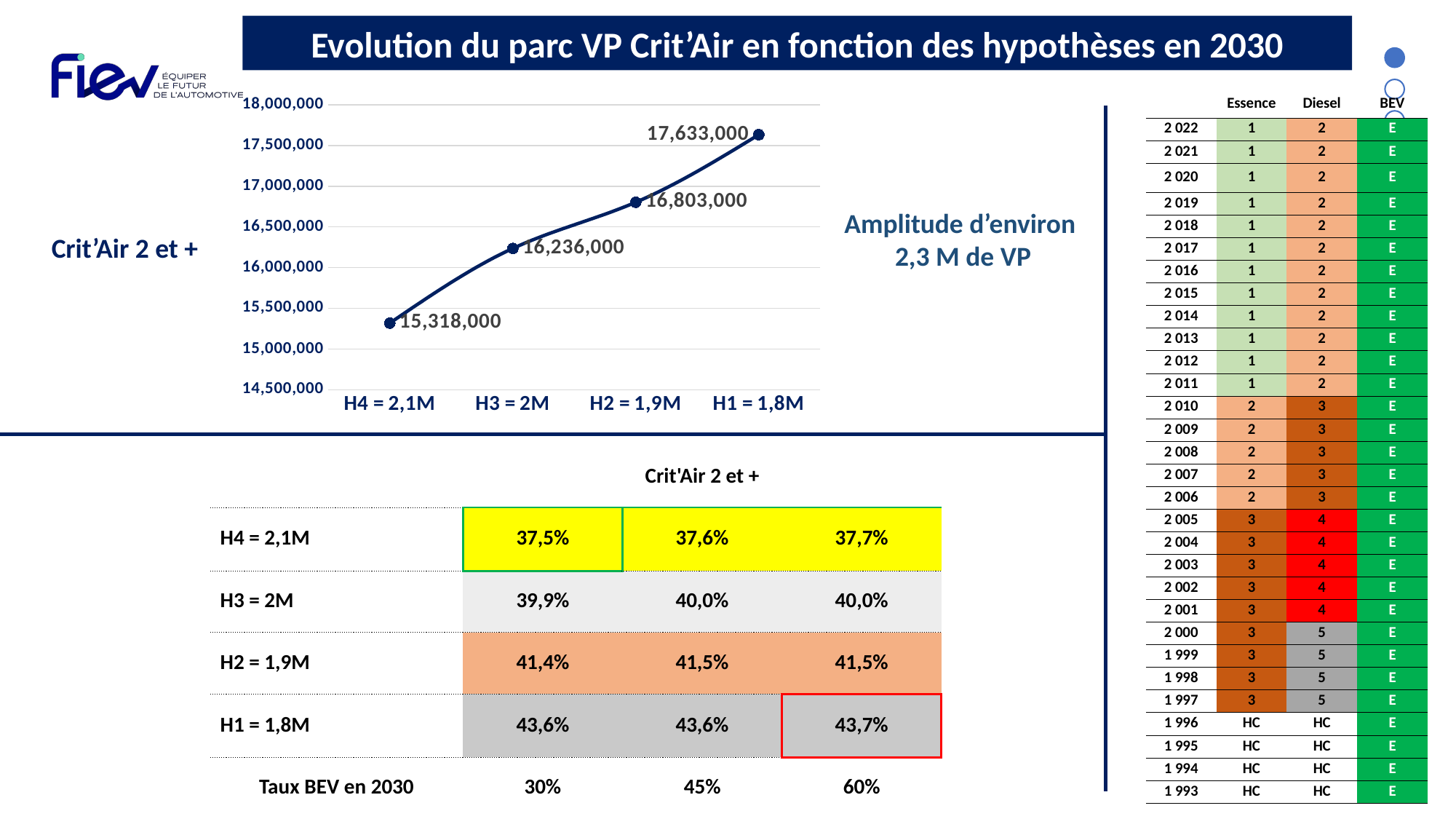
What is the value plotted for H4 = 2,1M? 15,318,000 What is the difference between the values for H2 = 1,9M and H3 = 2M? 567,000 What is the value plotted for H1 = 1,8M? 17,633,000 Do the plotted values rise or fall from H4 = 2,1M to H1 = 1,8M along the x axis? Rise What kind of chart is shown on the slide? Line chart What is the difference between the values for H1 = 1,8M and H4 = 2,1M? 2,315,000 What is the value plotted for H2 = 1,9M? 16,803,000 Which hypothesis has the highest plotted value? H1 = 1,8M Which hypothesis has the lowest plotted value? H4 = 2,1M Which is larger, the value for H3 = 2M or the value for H2 = 1,9M? H2 = 1,9M How many data points are plotted on the line chart? 4 What is the value plotted for H3 = 2M? 16,236,000